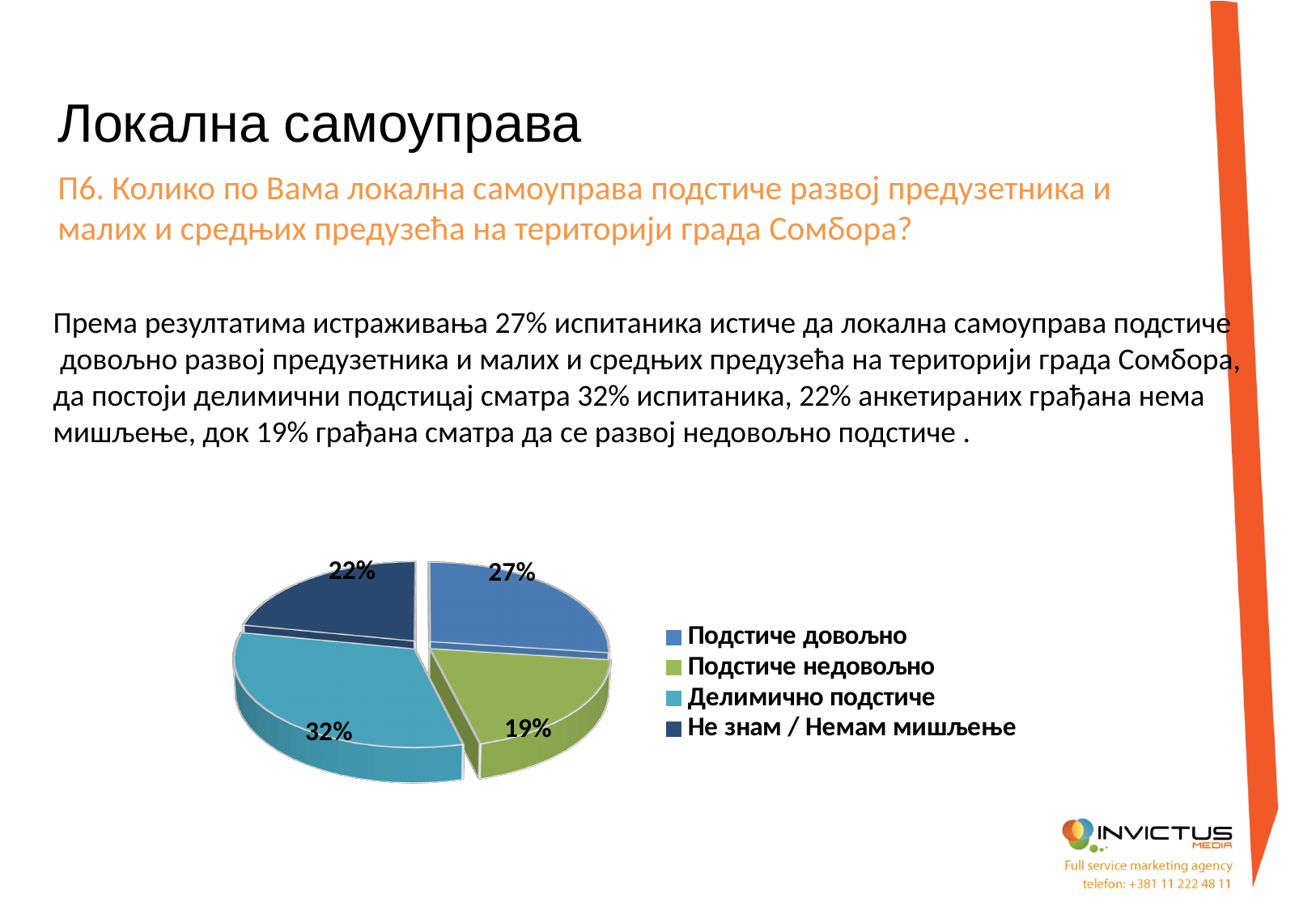
What is the difference in percentage points between "Делимично подстиче" and "Подстиче недовољно"? 13 What colour is the slice for "Подстиче недовољно"? green Which category has the smallest slice of the pie? Подстиче недовољно What share of respondents answered "Подстиче недовољно"? 19% What kind of chart is shown on the slide? pie chart How many entries does the legend list? 4 Which is larger: the share for "Подстиче довољно" or the share for "Не знам / Немам мишљење"? Подстиче довољно What share of respondents answered "Делимично подстиче"? 32% Which category has the largest slice of the pie? Делимично подстиче How many slices does the pie chart have? 4 What share of respondents answered "Подстиче довољно"? 27% What share of respondents answered "Не знам / Немам мишљење"? 22%